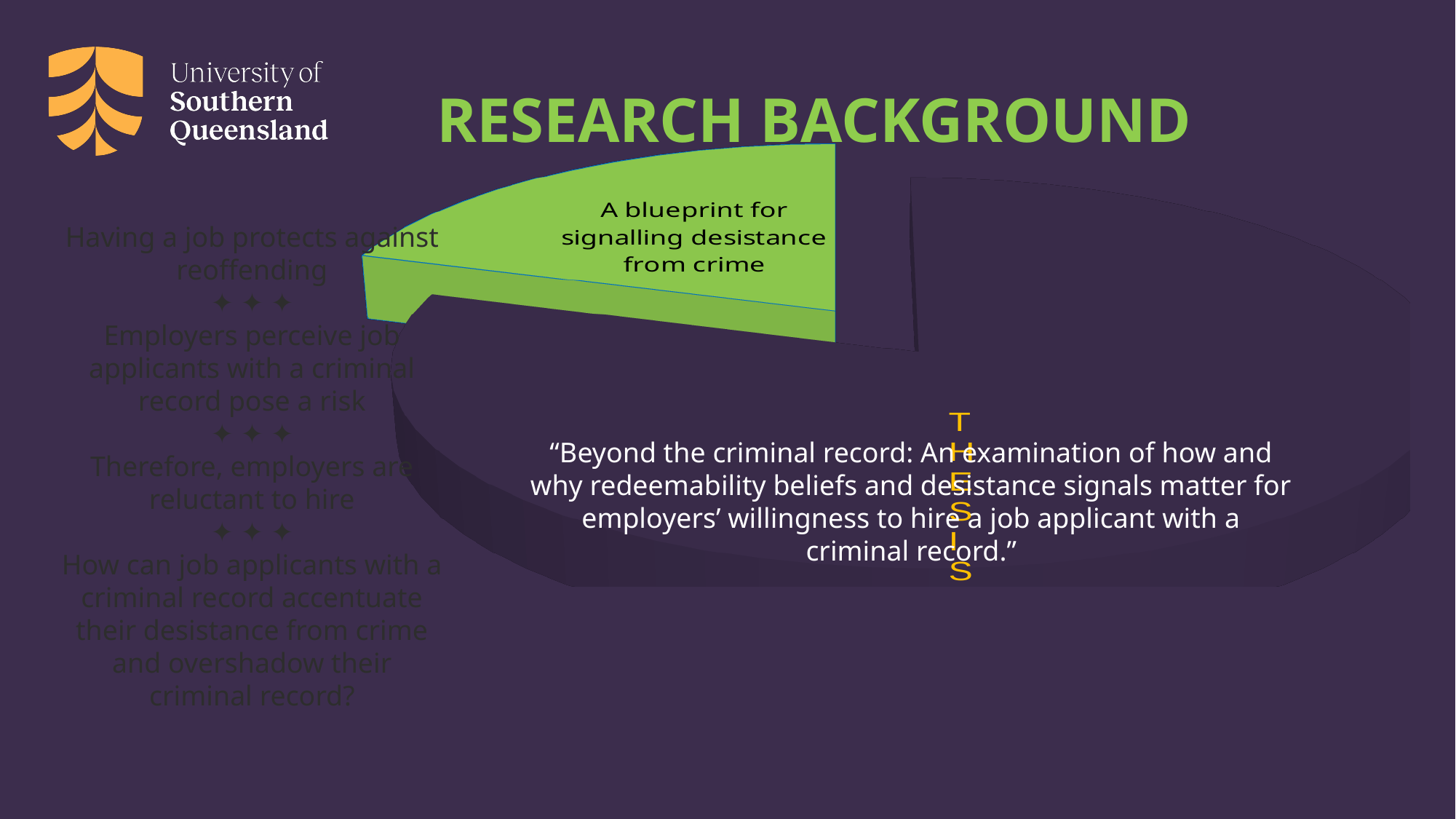
What kind of chart is shown on the slide? Pie chart Which slice of the pie chart is the smallest? A blueprint for signalling desistance from crime How many slices does the pie chart have? 2 What label is printed on the green slice of the pie chart? A blueprint for signalling desistance from crime Which is larger: the green slice or the dark purple slice labelled THESIS? The dark purple slice (THESIS) What colour is the slice that is pulled out from the rest of the pie chart? Green